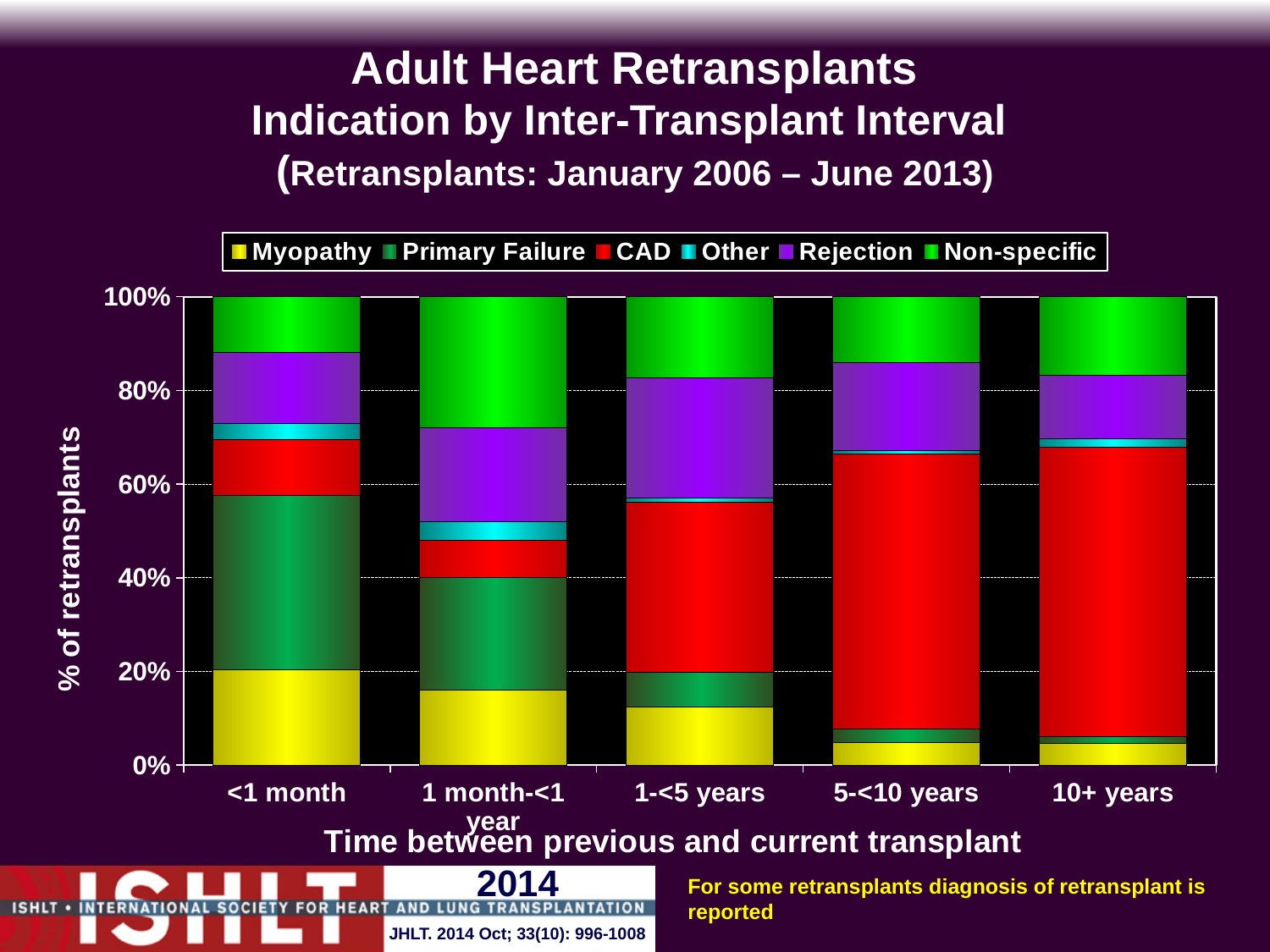
Moving from <1 month to 10+ years, does the Primary Failure share get larger or smaller? smaller What is the label of the y axis? % of retransplants Is the CAD share for the 5-<10 years category greater or less than 40%? greater How many series does the legend list? 6 What is the label of the x axis? Time between previous and current transplant Which category has the largest Rejection share? 1-<5 years What kind of chart is shown on the slide? stacked bar chart Which category has the largest Primary Failure share? <1 month How many inter-transplant interval categories are shown on the x axis? 5 Is the Primary Failure share for the <1 month category greater or less than 20%? greater Is the Myopathy share for the 1-<5 years category greater or less than 20%? less Is the CAD share larger for the <1 month category or the 10+ years category? 10+ years